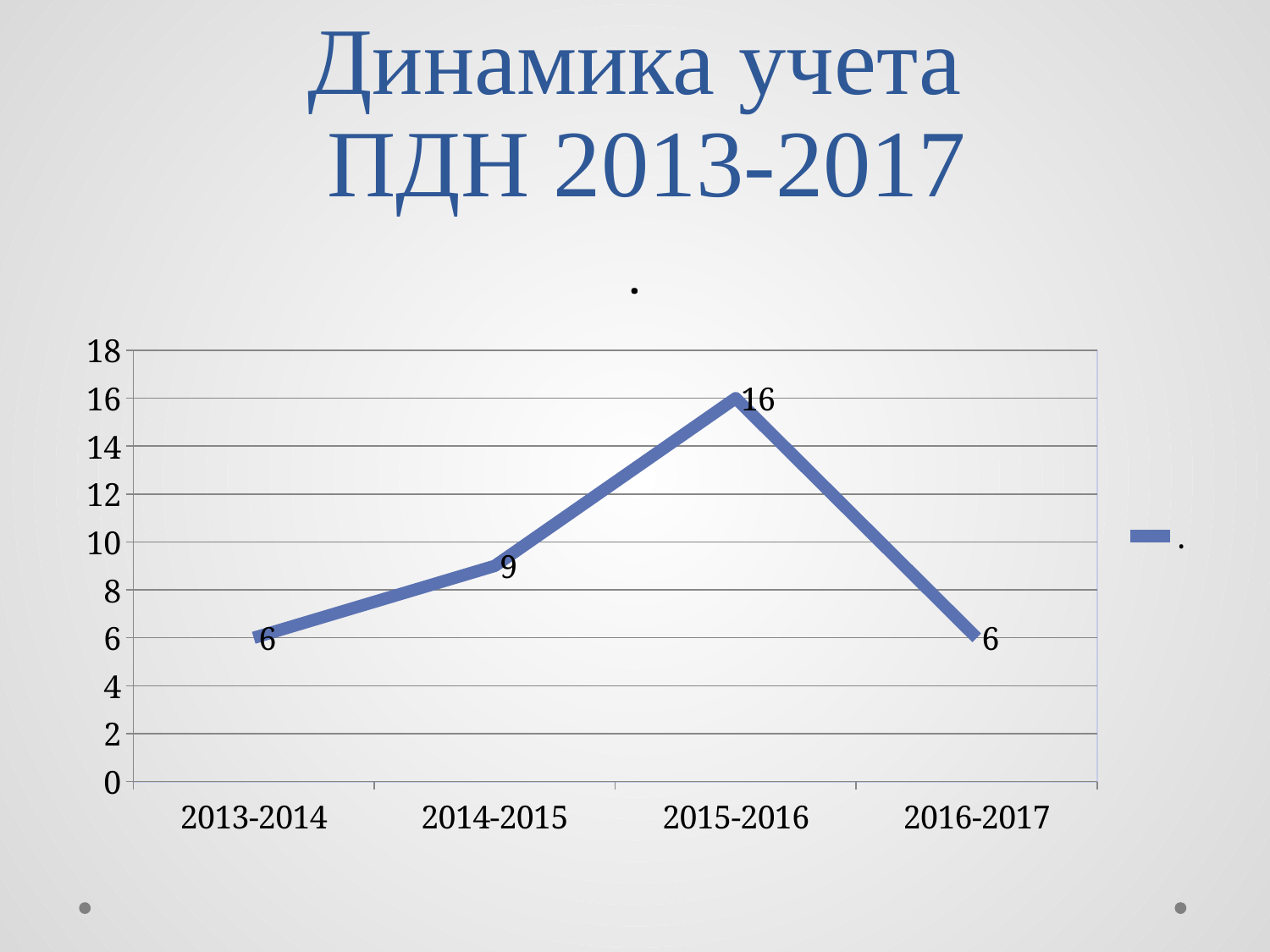
What is the value for 2014-2015? 9 What kind of chart is shown on the slide? line chart Which period has the highest value? 2015-2016 Does the value rise or fall from 2015-2016 to 2016-2017? fall What is the value for 2016-2017? 6 Which is larger, the value for 2014-2015 or the value for 2016-2017? 2014-2015 What is the value for 2015-2016? 16 What is the difference between the values for 2015-2016 and 2014-2015? 7 Is the value for 2015-2016 greater or less than 14? greater How many periods are plotted on the x axis? 4 What is the difference between the values for 2015-2016 and 2016-2017? 10 What is the value for 2013-2014? 6